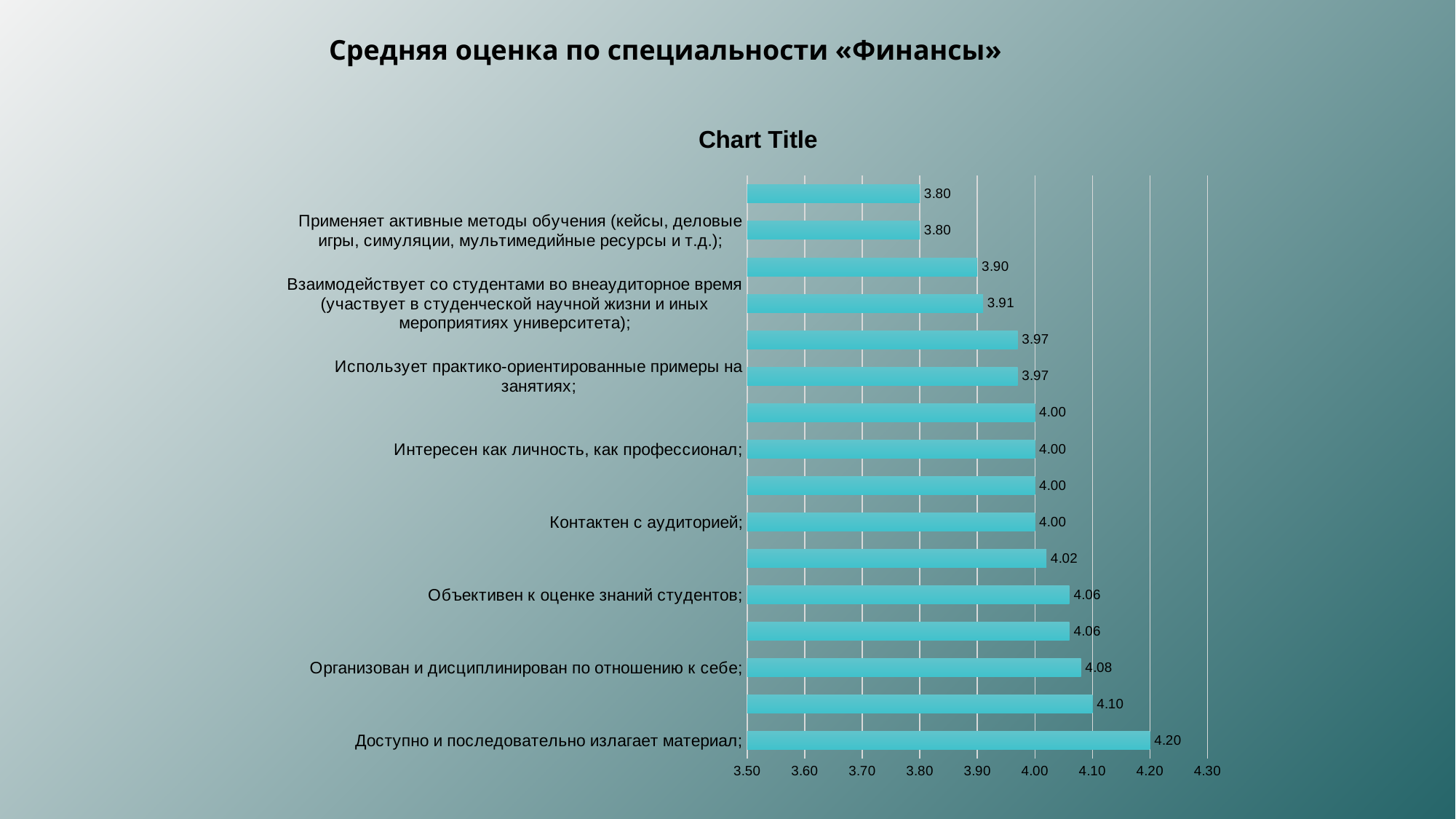
What is the difference between the values for «Доступно и последовательно излагает материал» and «Организован и дисциплинирован по отношению к себе»? 0.12 How many bars are plotted on the chart? 16 What kind of chart is shown on the slide? Bar chart Which is larger: the value for «Объективен к оценке знаний студентов» or the value for «Контактен с аудиторией»? Объективен к оценке знаний студентов What is the value for «Контактен с аудиторией»? 4.00 What is the value for «Организован и дисциплинирован по отношению к себе»? 4.08 What is the value for «Объективен к оценке знаний студентов»? 4.06 What is the lowest value shown on the chart? 3.80 What is the value for «Доступно и последовательно излагает материал»? 4.20 What is the value for «Применяет активные методы обучения (кейсы, деловые игры, симуляции, мультимедийные ресурсы и т.д.)»? 3.80 Which category has the highest value? Доступно и последовательно излагает материал What is the highest value shown on the chart? 4.20